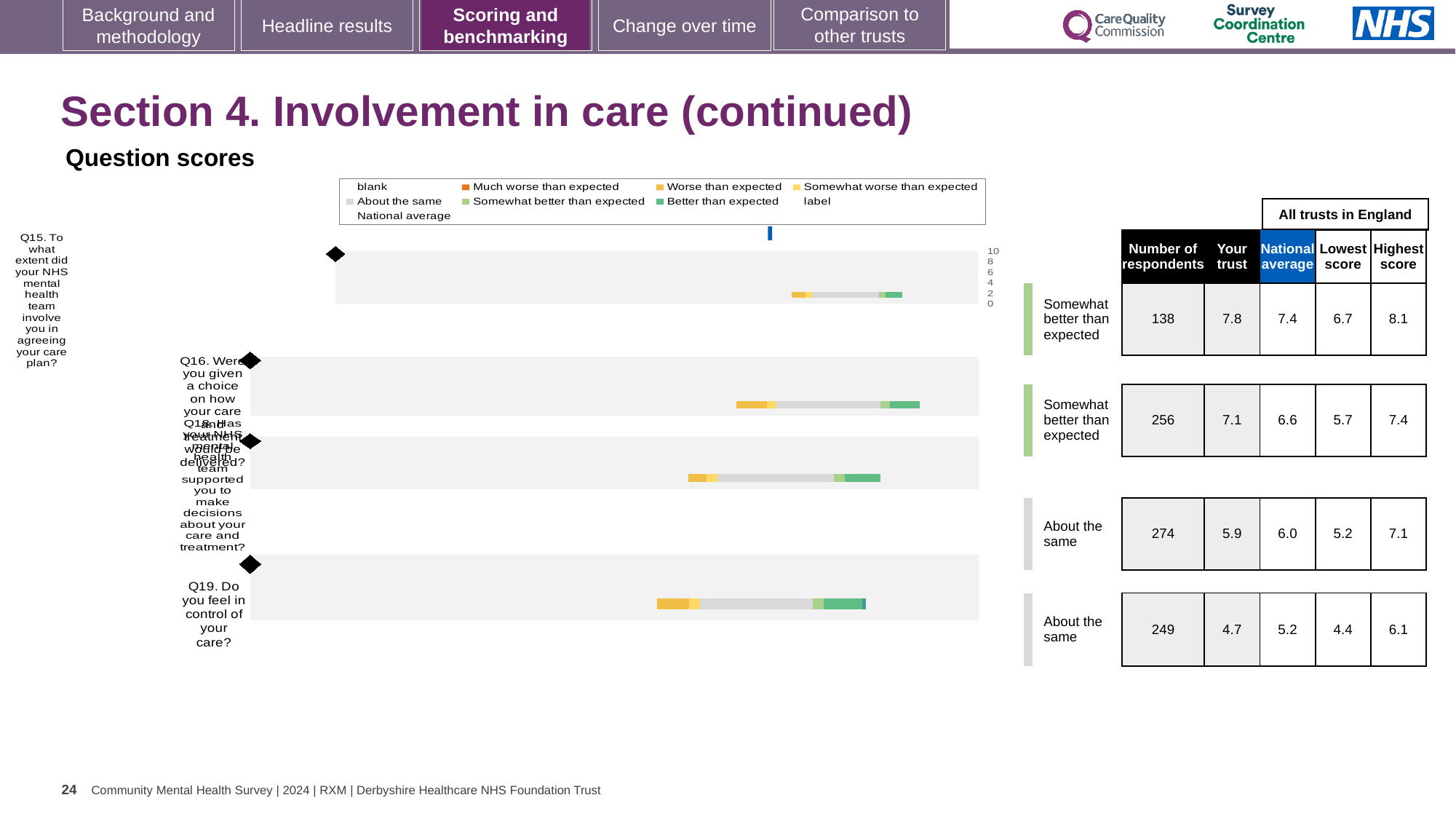
What is the difference between the 'Your trust' score and the national average for Q15? 0.4 How many questions (categories) are plotted in the question scores chart? 4 How many respondents answered Q16 (choice on how care and treatment would be delivered)? 256 Which question has the highest 'Your trust' score? Q15 Which question has the lowest 'Your trust' score? Q19 Is the 'Your trust' score for Q19 greater or less than 6? less What is the national average score for Q18 (supported you to make decisions about your care and treatment)? 6.0 For Q18, which is larger: the 'Your trust' score or the national average? National average What kind of chart is used to show the question scores on this slide? bar chart What is the highest score among all trusts in England for Q19 (do you feel in control of your care)? 6.1 What benchmark category is shown for Q15 and Q16? Somewhat better than expected What is the 'Your trust' score for Q15 (involving you in agreeing your care plan)? 7.8